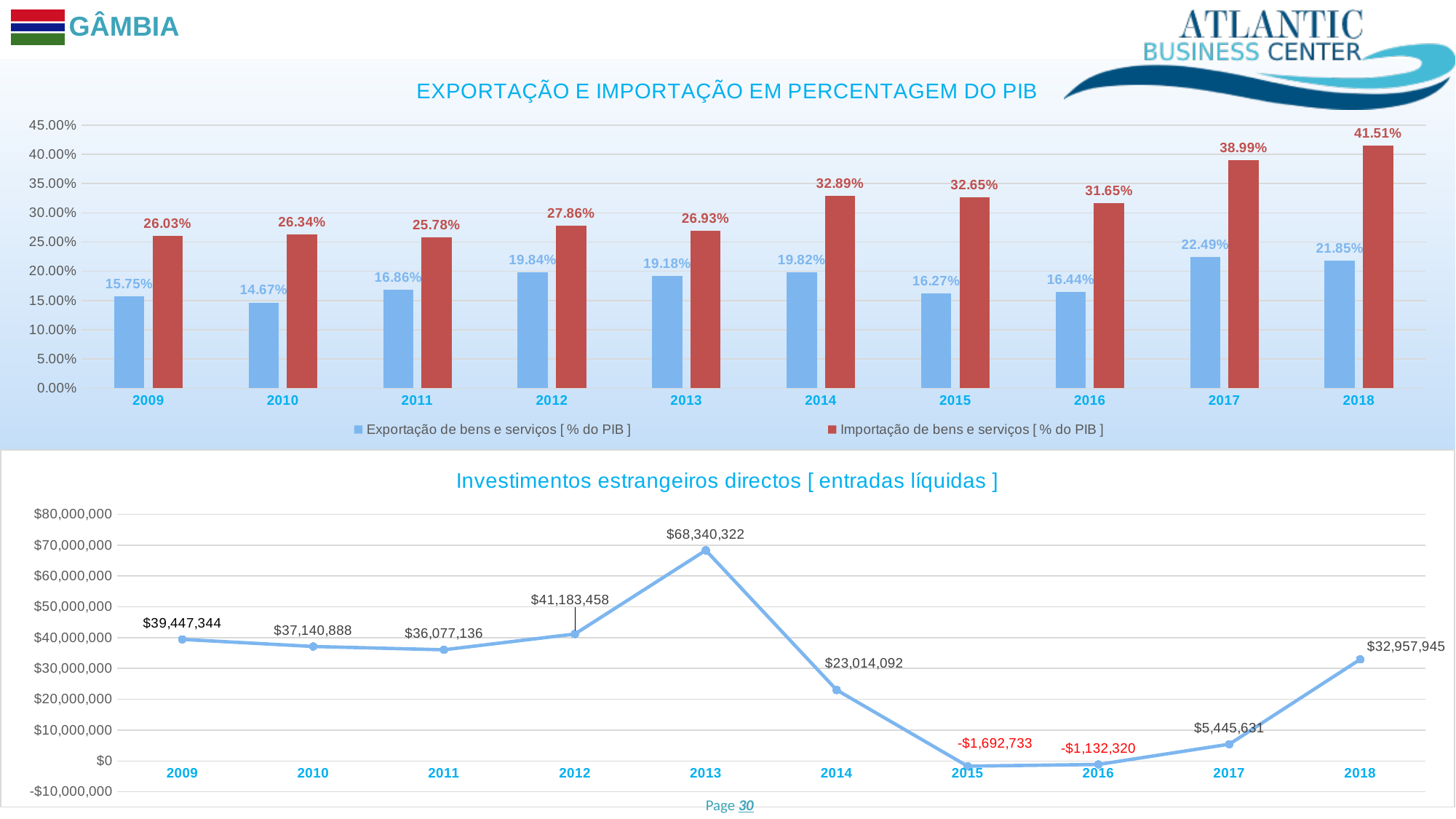
In the chart 'EXPORTAÇÃO E IMPORTAÇÃO EM PERCENTAGEM DO PIB', what is the value of Importação de bens e serviços in 2018? 41.51% What kind of chart is 'EXPORTAÇÃO E IMPORTAÇÃO EM PERCENTAGEM DO PIB'? Bar chart In the chart 'EXPORTAÇÃO E IMPORTAÇÃO EM PERCENTAGEM DO PIB', how many series does the legend list? 2 In the chart 'Investimentos estrangeiros directos [ entradas líquidas ]', do the values rise or fall from 2013 to 2015? Fall In the chart 'Investimentos estrangeiros directos [ entradas líquidas ]', is the value for 2010 larger or smaller than the value for 2011? Larger In the chart 'EXPORTAÇÃO E IMPORTAÇÃO EM PERCENTAGEM DO PIB', what is the difference between Importação and Exportação in 2017? 16.50% In the chart 'EXPORTAÇÃO E IMPORTAÇÃO EM PERCENTAGEM DO PIB', which year has the lowest Exportação de bens e serviços value? 2010 In the chart 'Investimentos estrangeiros directos [ entradas líquidas ]', what is the value for 2013? $68,340,322 In the chart 'Investimentos estrangeiros directos [ entradas líquidas ]', which year has the lowest value? 2015 In the chart 'EXPORTAÇÃO E IMPORTAÇÃO EM PERCENTAGEM DO PIB', what is the value of Exportação de bens e serviços in 2012? 19.84% In the chart 'EXPORTAÇÃO E IMPORTAÇÃO EM PERCENTAGEM DO PIB', how many years are shown on the x axis? 10 What kind of chart is 'Investimentos estrangeiros directos [ entradas líquidas ]'? Line chart